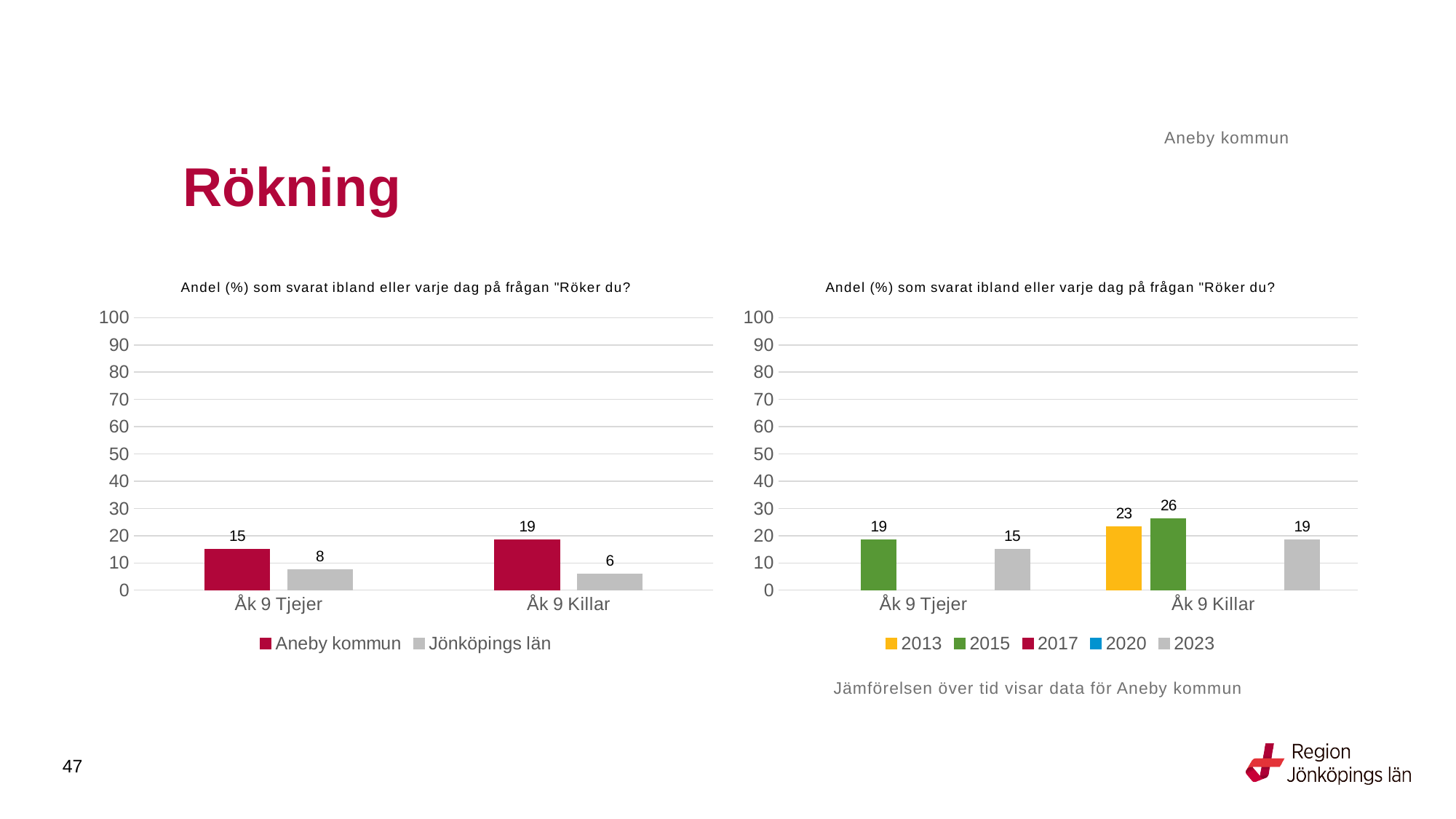
In the left chart, what is the difference between Aneby kommun and Jönköpings län for Åk 9 Killar? 13 In the left chart, what is the value for Jönköpings län for Åk 9 Killar? 6 What kind of chart is the left chart? bar chart In the right chart, which year has the highest value for Åk 9 Killar? 2015 In the left chart, what is the value for Aneby kommun for Åk 9 Tjejer? 15 In the left chart, which is larger for Åk 9 Tjejer: Aneby kommun or Jönköpings län? Aneby kommun In the left chart, how many series does the legend list? 2 In the right chart, what is the value for 2023 for Åk 9 Tjejer? 15 In the right chart, what is the difference between 2013 and 2023 for Åk 9 Killar? 4 In the right chart, what is the value for 2015 for Åk 9 Killar? 26 In the right chart, is the value for 2015 for Åk 9 Tjejer greater or less than 10? greater In the right chart, how many series does the legend list? 5